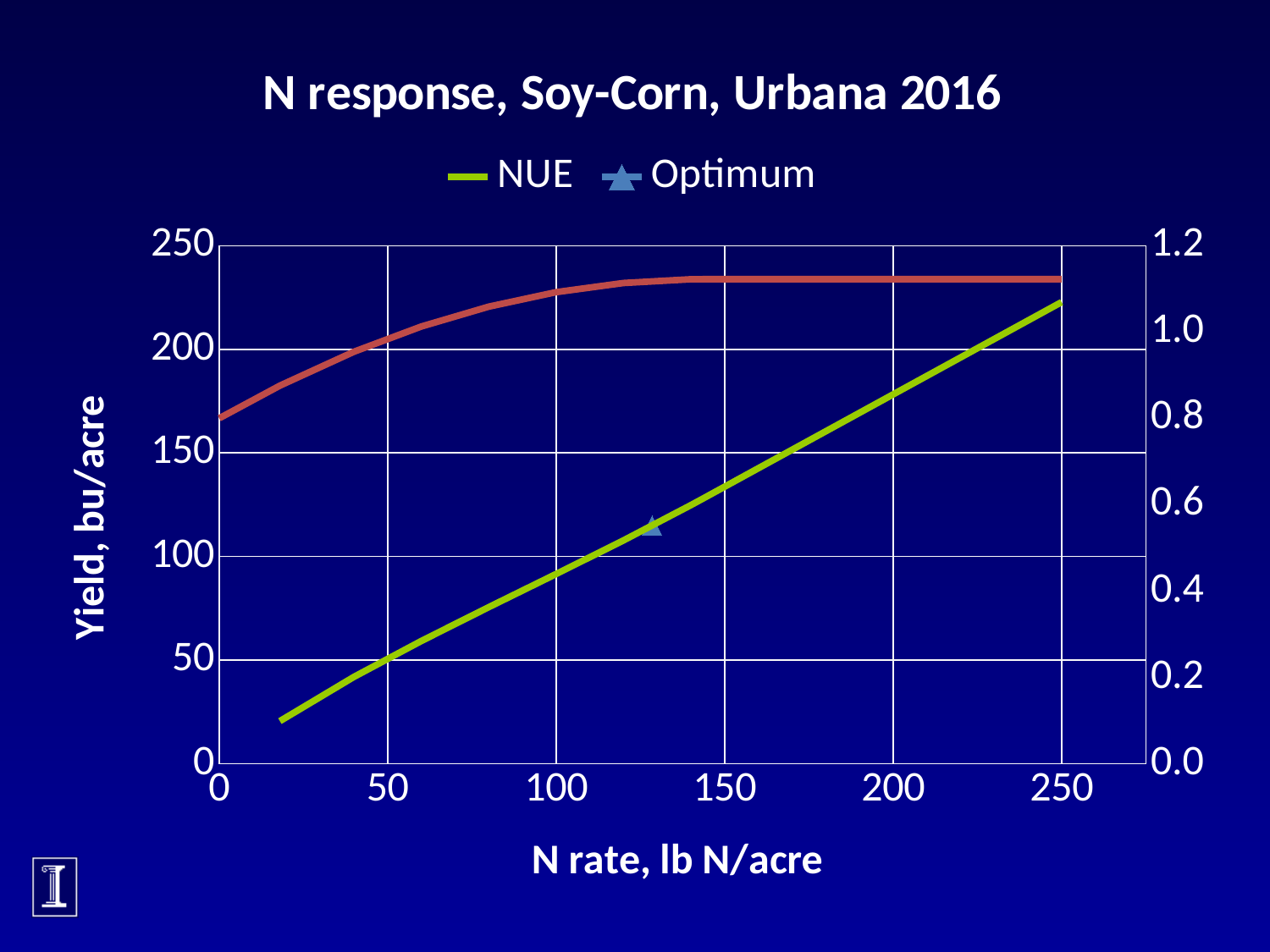
Is the Optimum marker located at an N rate greater or less than 150 lb N/acre? less Is the yield value of the red line at an N rate of 0 greater or less than 150 bu/acre? greater Is the yield value of the red line at an N rate of 250 greater or less than 200 bu/acre? greater Does the red yield line rise or fall between an N rate of 0 and 100 lb N/acre? rises What type of chart is shown on the slide? line chart Does the NUE line rise or fall as the N rate increases? rises What is the title of the chart? N response, Soy-Corn, Urbana 2016 What is the highest value shown on the right-hand axis? 1.2 How many series does the legend list? 2 What is the label of the x axis? N rate, lb N/acre